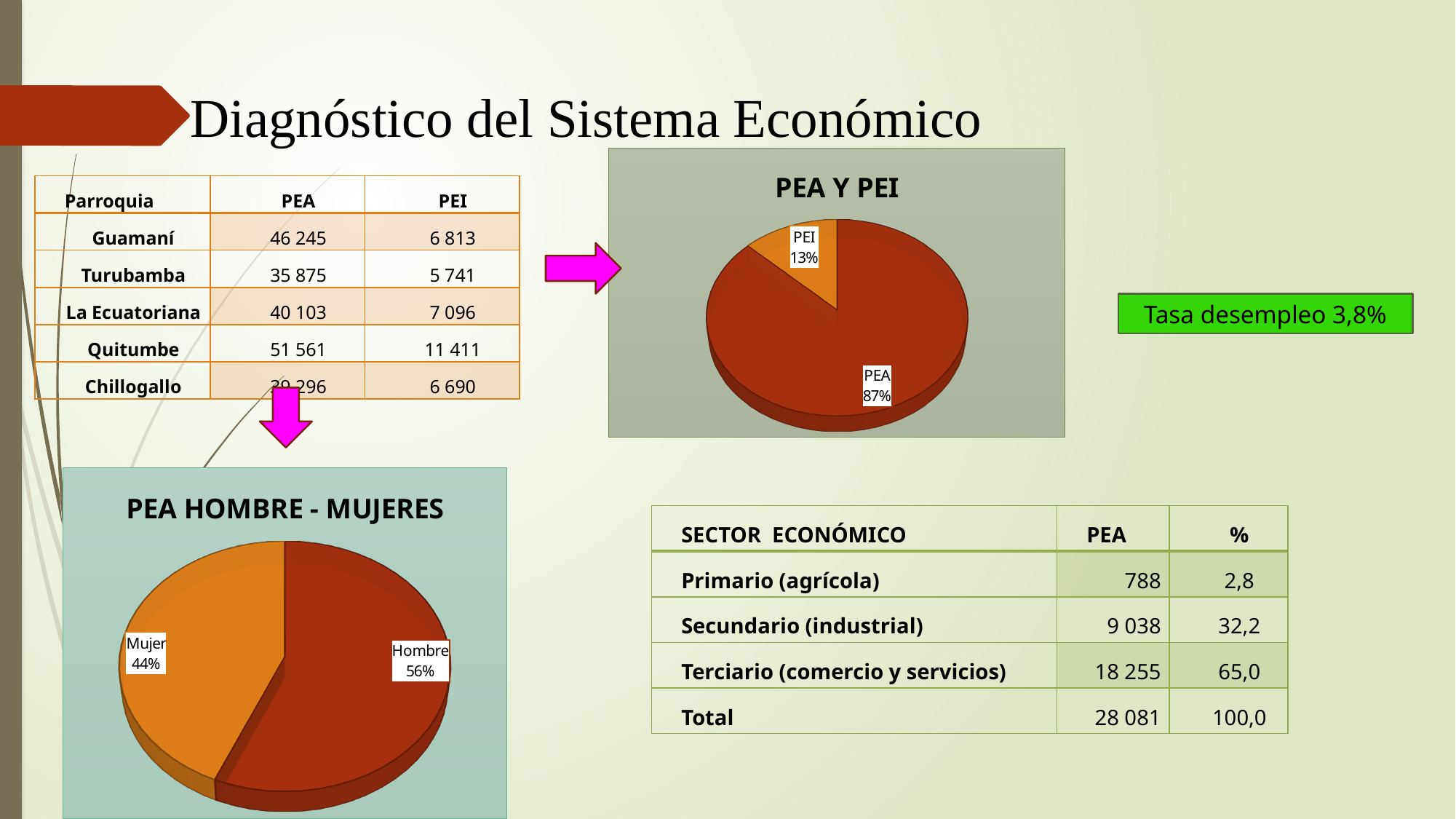
In the 'PEA HOMBRE - MUJERES' chart, which slice is the smallest? Mujer What kind of chart is the 'PEA Y PEI' chart? Pie chart In the 'PEA HOMBRE - MUJERES' chart, what share does Mujer have? 44% In the 'PEA Y PEI' chart, which slice is the largest? PEA In the 'PEA Y PEI' chart, what share does PEI have? 13% How many slices does the 'PEA Y PEI' chart have? 2 In the 'PEA Y PEI' chart, what is the difference in percentage points between PEA and PEI? 74 In the 'PEA Y PEI' chart, what share does PEA have? 87% In the 'PEA HOMBRE - MUJERES' chart, what is the difference in percentage points between Hombre and Mujer? 12 What is the title of the pie chart in the lower left of the slide? PEA HOMBRE - MUJERES In the 'PEA HOMBRE - MUJERES' chart, what share does Hombre have? 56% In the 'PEA HOMBRE - MUJERES' chart, which is larger, Hombre or Mujer? Hombre